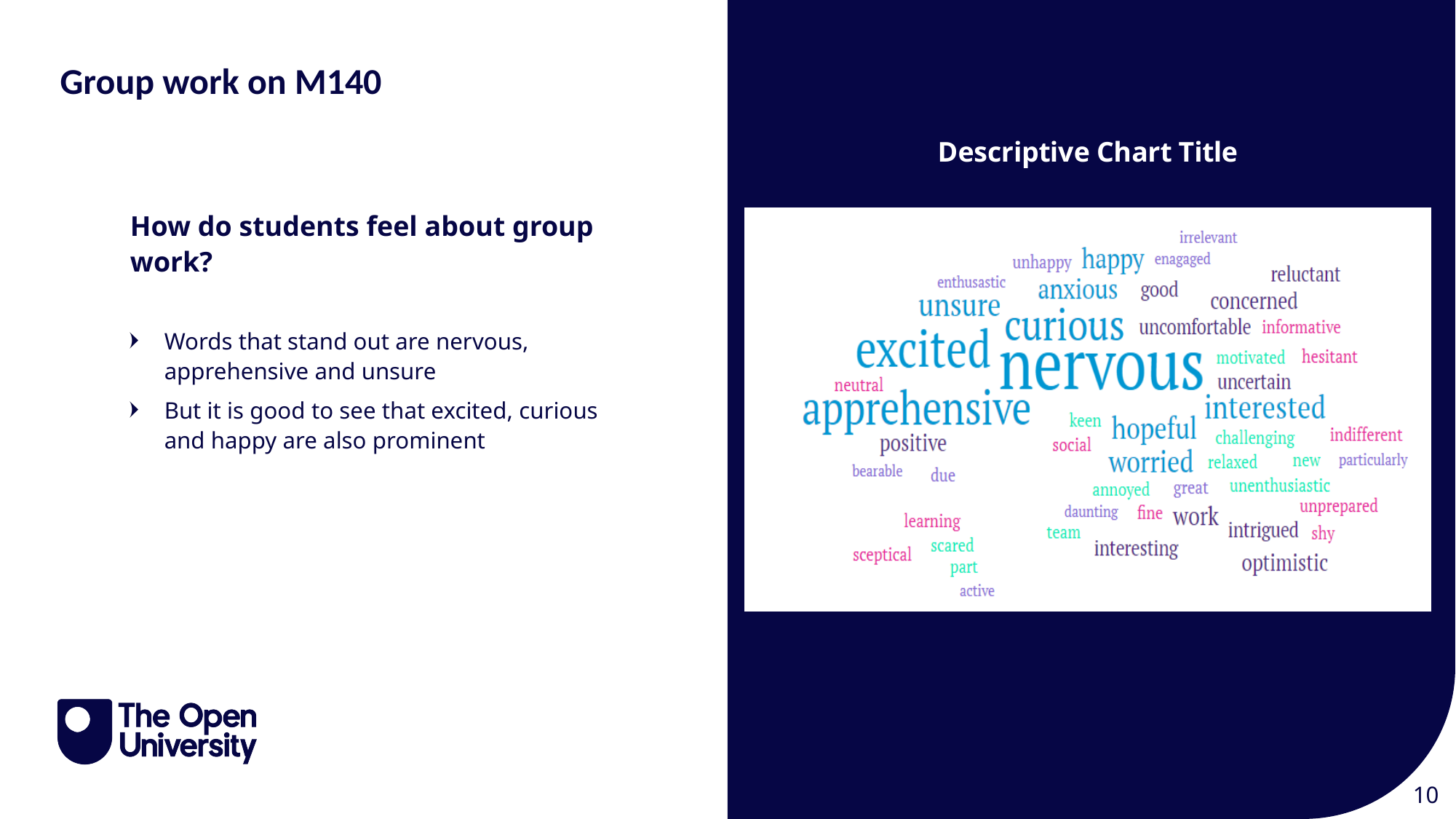
Which word is displayed larger in the word cloud, excited or active? excited Which word appears largest in the word cloud? nervous Which word is displayed larger in the word cloud, apprehensive or bearable? apprehensive Which word is displayed larger in the word cloud, curious or keen? curious What is the title shown above the word cloud? Descriptive Chart Title What colour is the word 'nervous' in the word cloud? blue What kind of chart is shown on the slide? word cloud